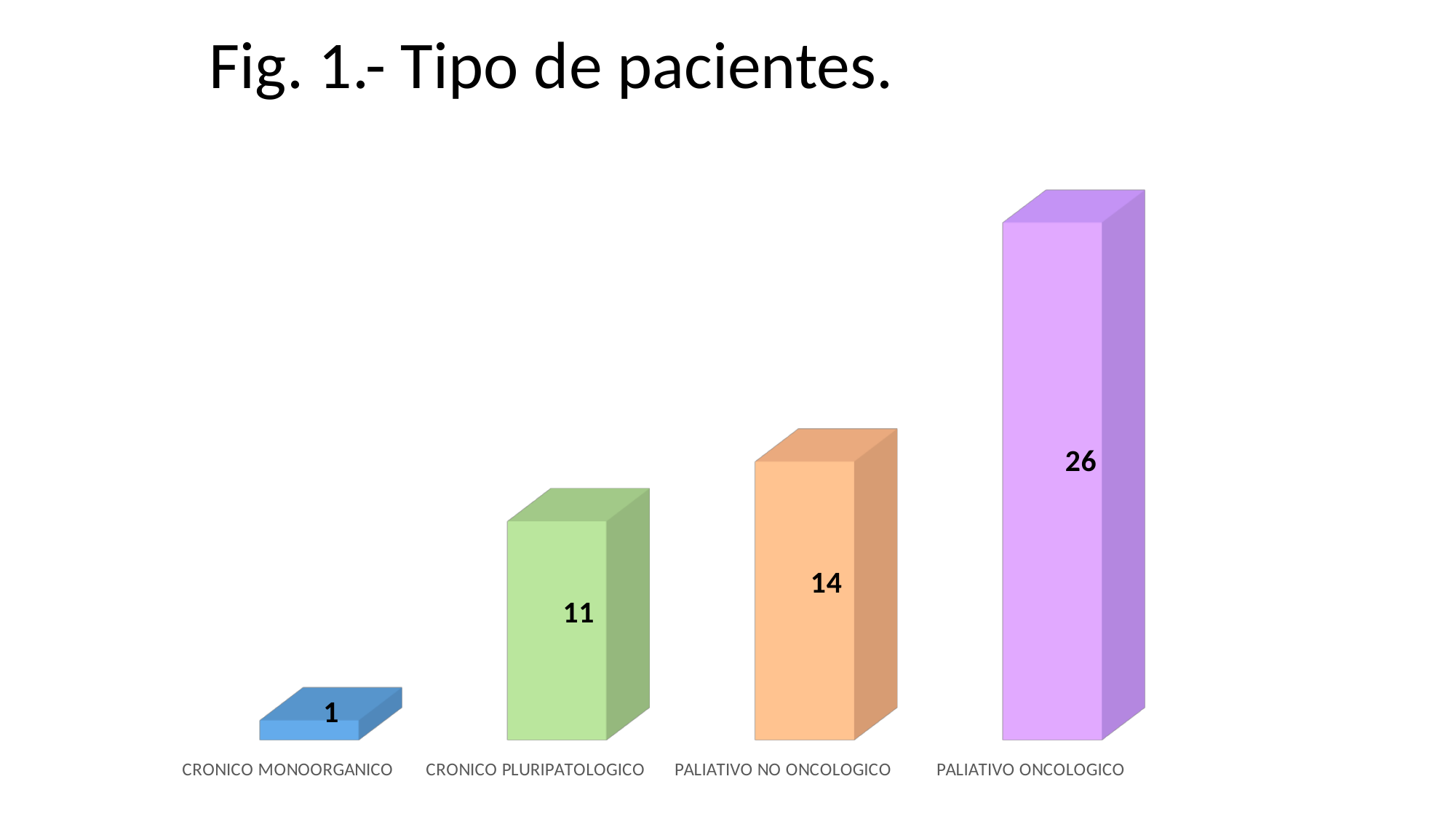
Do the values rise or fall from left to right across the categories? rise What is the value for CRONICO MONOORGANICO? 1 What is the difference between the values for PALIATIVO ONCOLOGICO and PALIATIVO NO ONCOLOGICO? 12 What kind of chart is shown on the slide? bar chart Which category has the lowest value? CRONICO MONOORGANICO What is the value for PALIATIVO ONCOLOGICO? 26 What is the difference between the values for CRONICO PLURIPATOLOGICO and CRONICO MONOORGANICO? 10 How many categories are shown in the chart? 4 Which category has the highest value? PALIATIVO ONCOLOGICO Which is larger, the value for CRONICO PLURIPATOLOGICO or the value for PALIATIVO NO ONCOLOGICO? PALIATIVO NO ONCOLOGICO What is the value for CRONICO PLURIPATOLOGICO? 11 What is the value for PALIATIVO NO ONCOLOGICO? 14